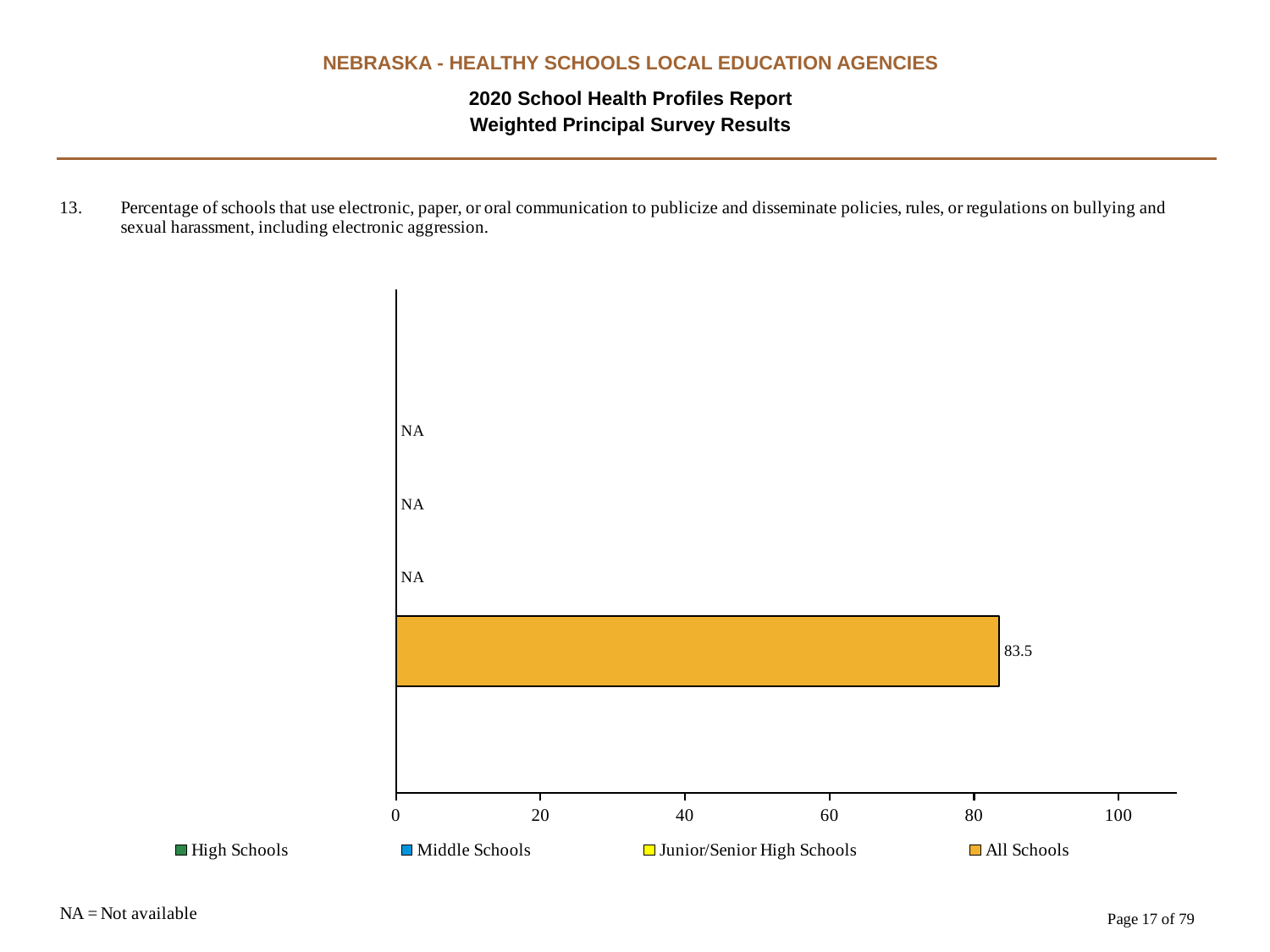
How many series have a plotted bar with a numeric value? 1 What value is shown for Middle Schools? NA Is the value for All Schools greater or less than 100? less What value is shown for High Schools? NA How many series does the legend list? 4 What is the highest tick value shown on the x axis? 100 According to the note on the slide, what does NA stand for? Not available What kind of chart is shown on the slide? Bar chart Is the value for All Schools greater or less than 80? greater Which series is the only one with a numeric value shown? All Schools What value is shown for Junior/Senior High Schools? NA What is the value for All Schools? 83.5